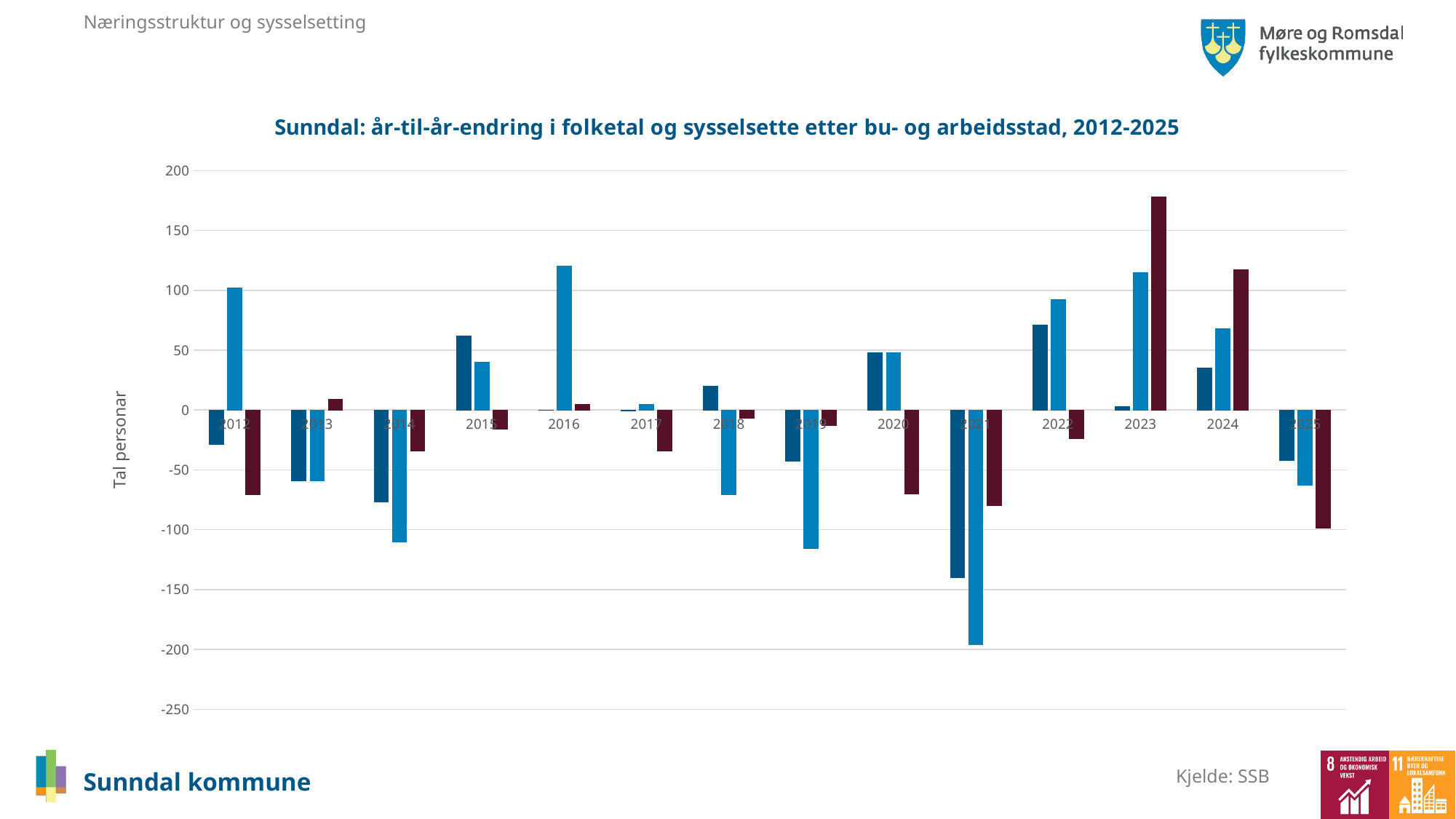
What is the label on the vertical axis of the chart? Tal personar In which year is the dark blue bar the lowest? 2021 Which is larger, the dark red bar for 2023 or the dark red bar for 2024? 2023 Is the value of the dark blue bar for 2021 greater or less than -100? less Is the value of the dark red bar for 2023 greater or less than 150? greater Is the value of the light blue bar for 2021 greater or less than -150? less In which year is the dark red bar the highest? 2023 What kind of chart is shown on the slide? bar chart What is the title of the chart? Sunndal: år-til-år-endring i folketal og sysselsette etter bu- og arbeidsstad, 2012-2025 In which year is the light blue bar the lowest? 2021 How many years are shown along the x axis of the chart? 14